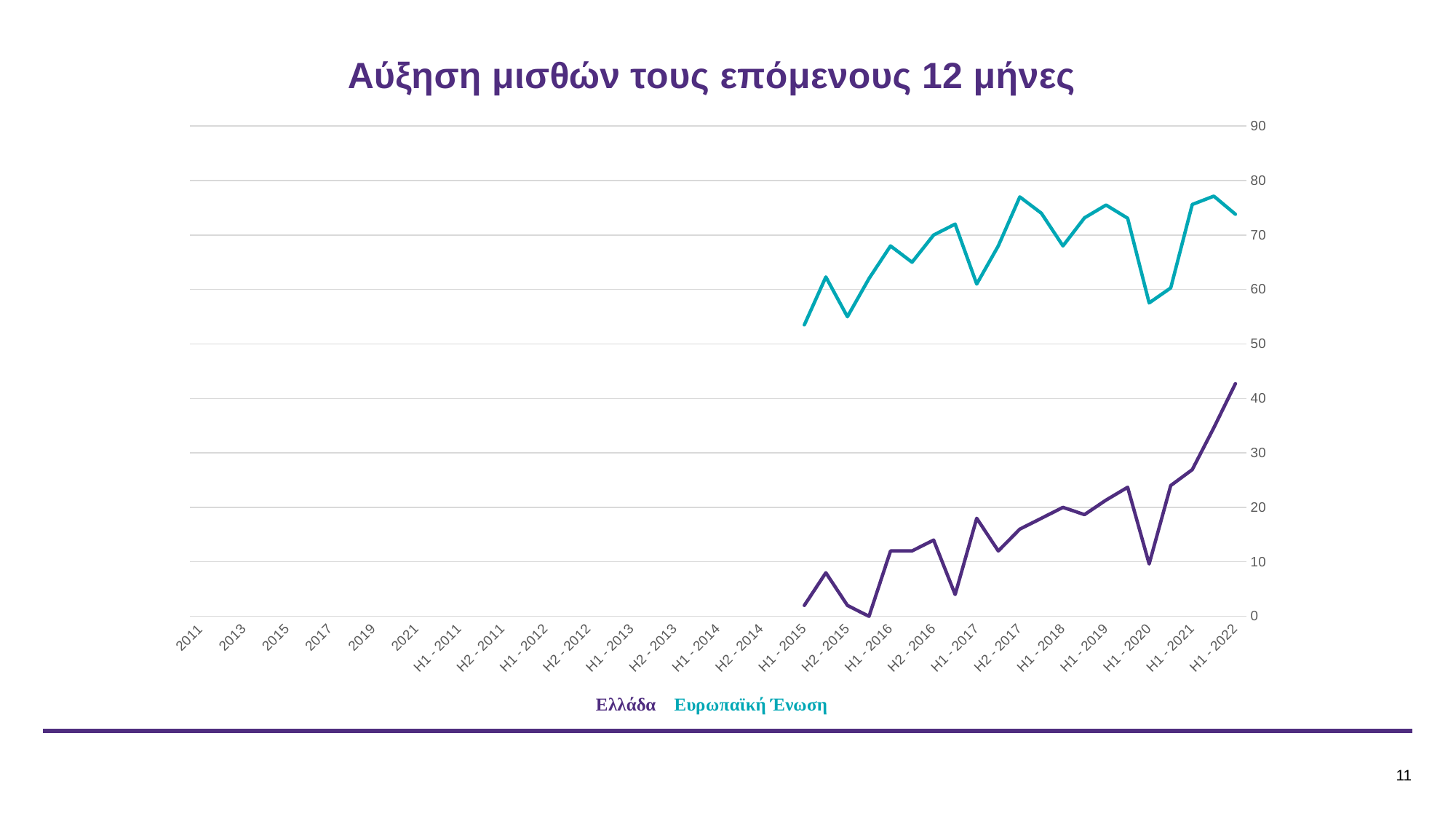
Is the value for Ευρωπαϊκή Ένωση at H1 - 2020 greater or less than 60? less Is the value for Ελλάδα at H1 - 2016 greater or less than 10? greater Is the value for Ελλάδα at H1 - 2021 greater or less than 20? greater Does the Ελλάδα series generally rise or fall from H1 - 2015 to H1 - 2022? rise How many series does the legend list? 2 At H1 - 2022, which series has the higher value, Ελλάδα or Ευρωπαϊκή Ένωση? Ευρωπαϊκή Ένωση At which point does the Ελλάδα series reach its highest value? H1 - 2022 What kind of chart is shown on the slide? line chart What is the title of the chart? Αύξηση μισθών τους επόμενους 12 μήνες Which series is drawn in purple? Ελλάδα